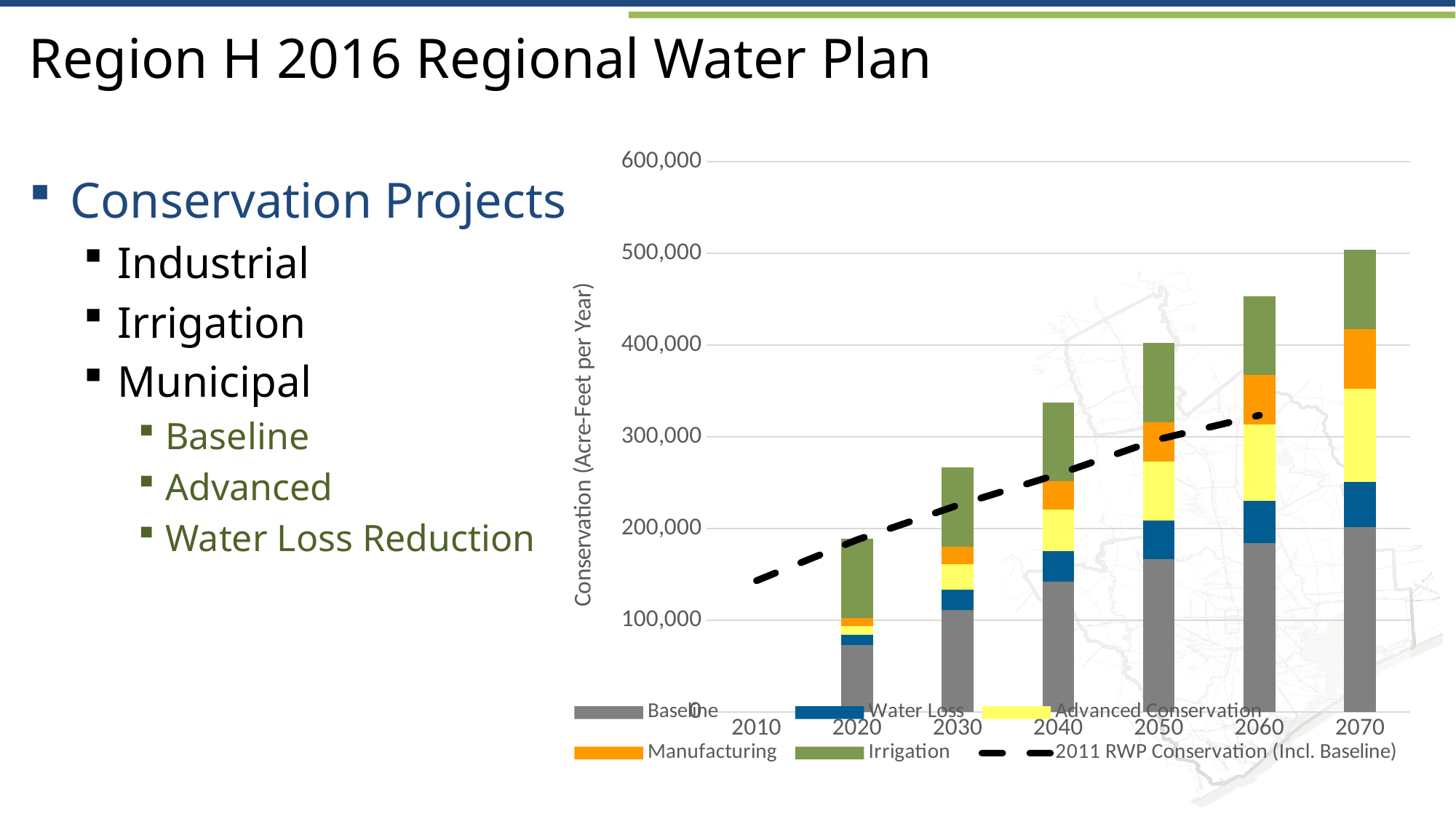
Is the total stacked bar for 2020 greater or less than 200,000? less Is the total stacked bar for 2040 greater or less than 300,000? greater Which year has the tallest stacked bar? 2070 Which year has the larger total stacked bar, 2050 or 2060? 2060 Is the total stacked bar for 2060 greater or less than 400,000? greater Which year has the shortest stacked bar? 2020 How many series does the chart legend list? 6 What kind of chart is shown on the slide? stacked bar chart with a dashed line (combination bar and line chart) How many years have a stacked bar plotted in the chart? 6 What is the label on the vertical axis of the chart? Conservation (Acre-Feet per Year) Which series is shown as a dashed black line in the chart? 2011 RWP Conservation (Incl. Baseline) Do the stacked bar totals rise or fall from 2020 to 2070? rise